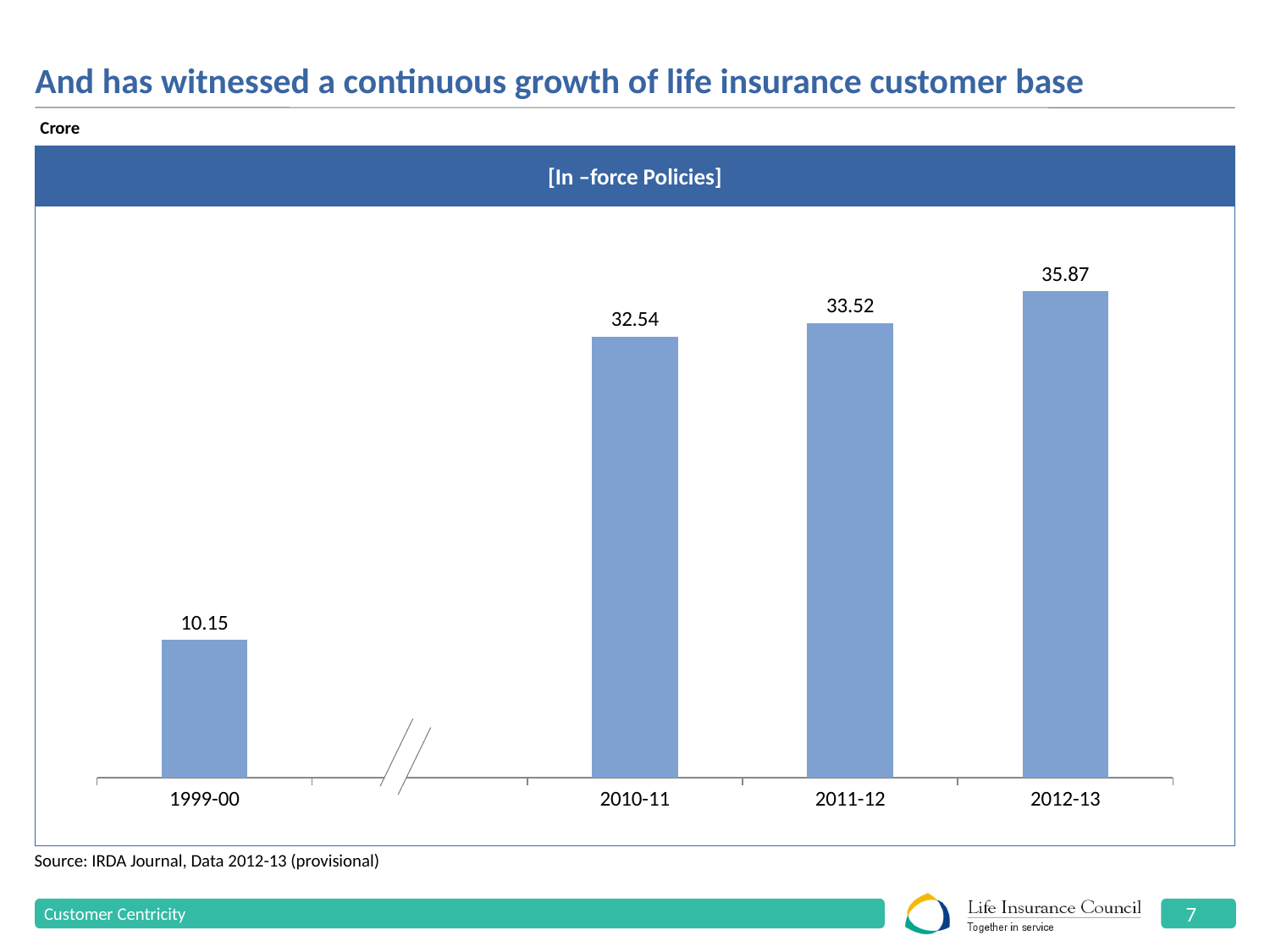
Which is larger, the value for 2011-12 or the value for 2010-11? 2011-12 What kind of chart is shown? bar chart What is the difference between the values for 2012-13 and 2011-12? 2.35 How many years are shown on the chart? 4 What is the difference between the values for 2010-11 and 1999-00? 22.39 Which year has the lowest value? 1999-00 What is the value for 2011-12? 33.52 What is the value for 2012-13? 35.87 What is the title of the chart? [In –force Policies] What is the value for 1999-00? 10.15 What is the value for 2010-11? 32.54 Which year has the highest value? 2012-13